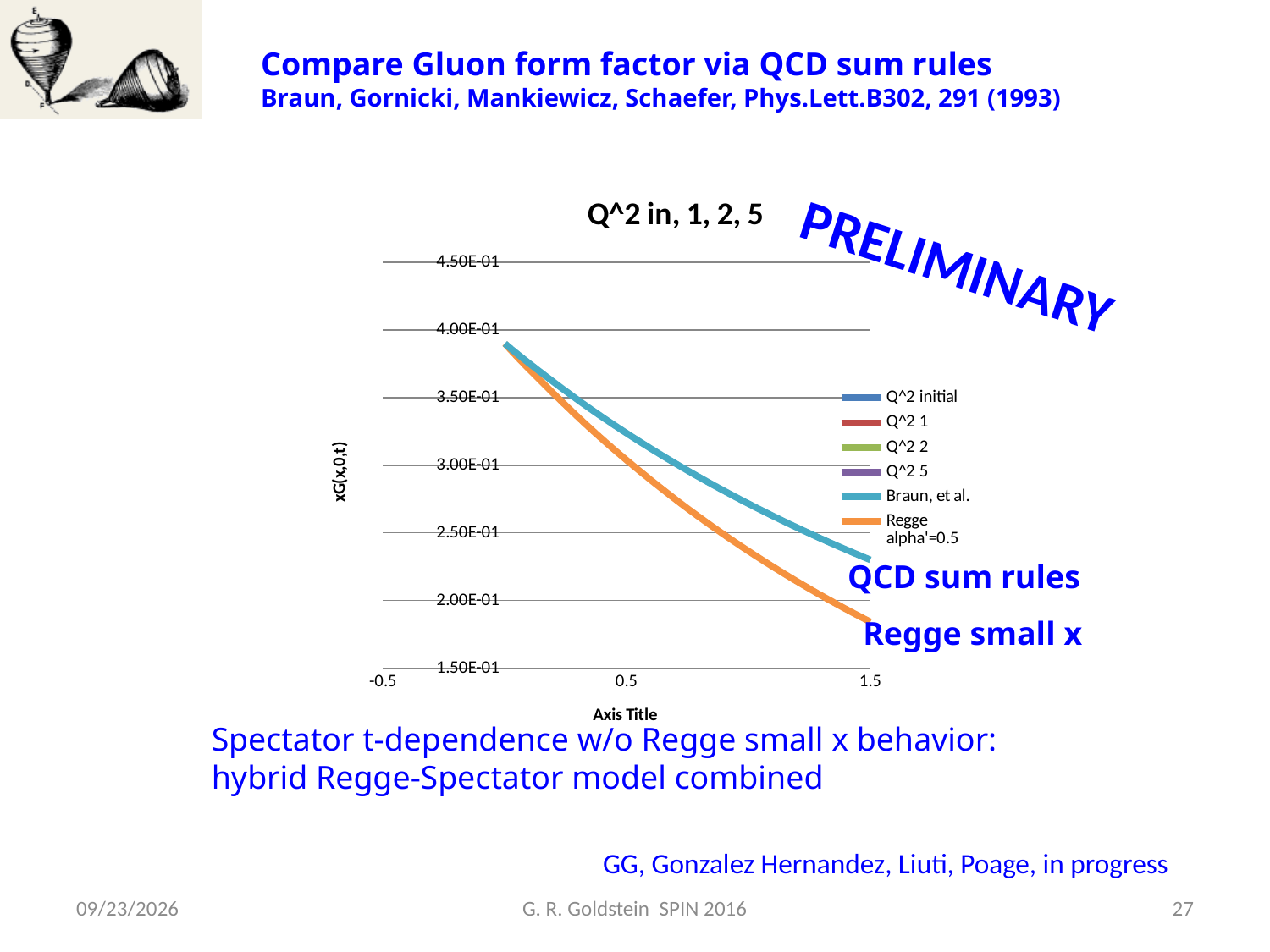
Is the value of the Regge alpha'=0.5 curve at x = 1.5 greater or less than 1.50E-01? greater At x = 1.5, which curve is higher: Braun, et al. or Regge alpha'=0.5? Braun, et al. Which plotted curve is lowest at x = 1.5? Regge alpha'=0.5 Do the plotted curves rise or fall as the x value increases? fall What kind of chart is shown on the slide? line chart How many series does the chart's legend list? 6 What is the title of the chart? Q^2 in, 1, 2, 5 Is the value of the Regge alpha'=0.5 curve at x = 1.5 greater or less than 2.00E-01? less Is the value of the Braun, et al. curve at x = 1.5 greater or less than 2.50E-01? less What is the label on the chart's vertical axis? xG(x,0,t)